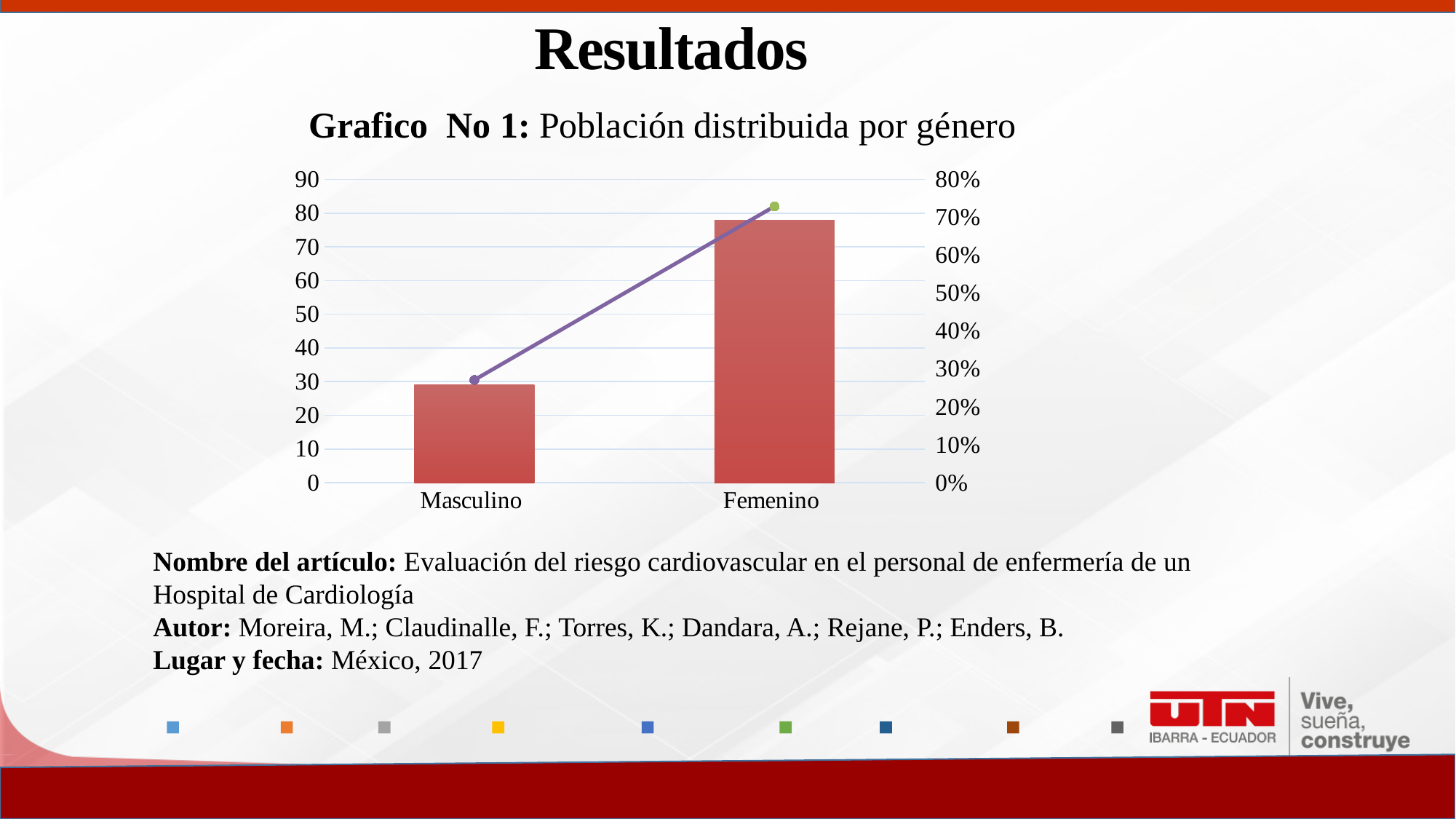
Which bar is taller, Masculino or Femenino? Femenino What kind of chart is shown on the slide? bar chart with a line Is the bar value for Femenino greater or less than 70? greater Which category has the tallest bar in the chart? Femenino Do the values rise or fall from Masculino to Femenino? rise Which category has the shortest bar in the chart? Masculino Is the bar value for Masculino greater or less than 20? greater How many categories are shown on the x axis of the chart? 2 What is the highest tick value shown on the right-hand axis of the chart? 80% Is the line value for Femenino on the right axis greater or less than 60%? greater What is the title of the chart? Grafico No 1: Población distribuida por género